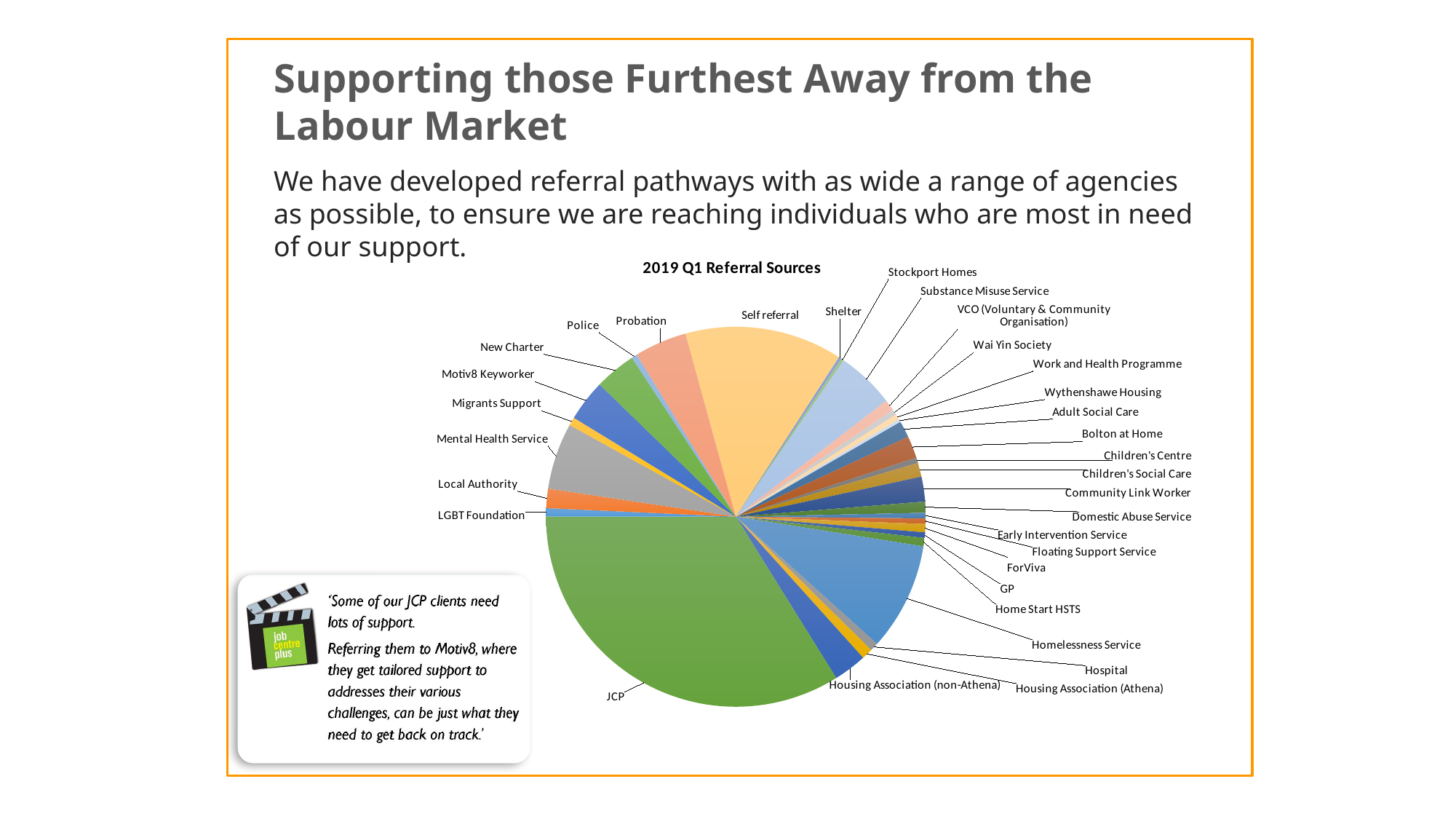
What kind of chart is shown on the slide? Pie chart Which is larger, the slice for Self referral or the slice for Probation? Self referral Which is larger, the slice for Mental Health Service or the slice for LGBT Foundation? Mental Health Service Which is larger, the slice for Homelessness Service or the slice for Hospital? Homelessness Service What colour is the JCP slice of the pie chart? Green How many referral sources are labelled on the pie chart? 32 What is the title of the chart? 2019 Q1 Referral Sources Which referral source has the largest slice of the pie? JCP